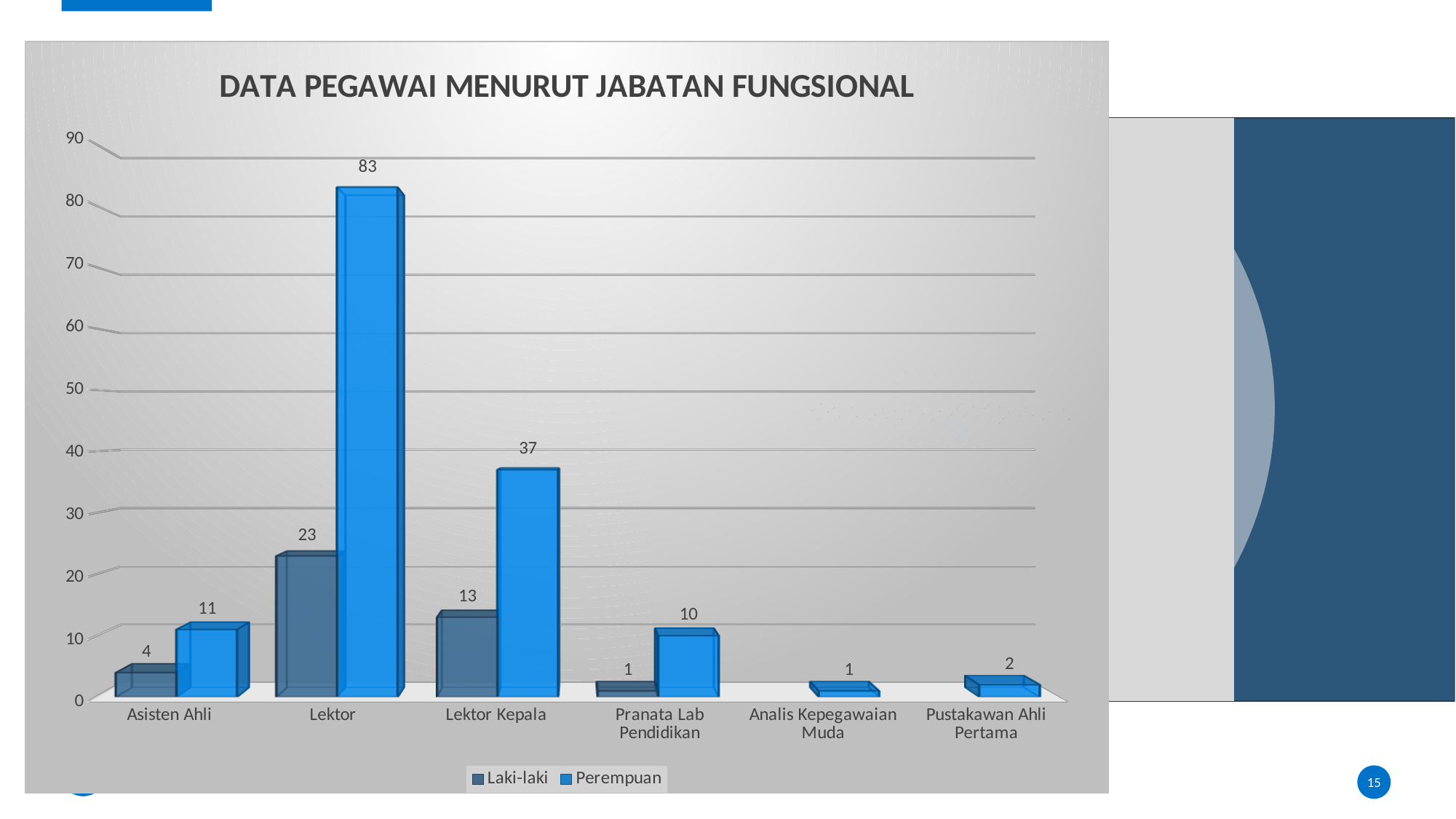
What is the Laki-laki value for Asisten Ahli? 4 How many series does the legend list? 2 What type of chart is shown on the slide? Bar chart Which is larger for Lektor Kepala, the Laki-laki value or the Perempuan value? Perempuan What is the difference between the Perempuan and Laki-laki values for Lektor? 60 Which category has the highest Perempuan value? Lektor What is the Laki-laki value for Lektor Kepala? 13 What is the Perempuan value for Pranata Lab Pendidikan? 10 How many categories are shown on the x axis? 6 Which category has the lowest Laki-laki value among those with a Laki-laki bar shown? Pranata Lab Pendidikan Is the Perempuan value for Lektor greater or less than 80? greater What is the Perempuan value for Lektor? 83